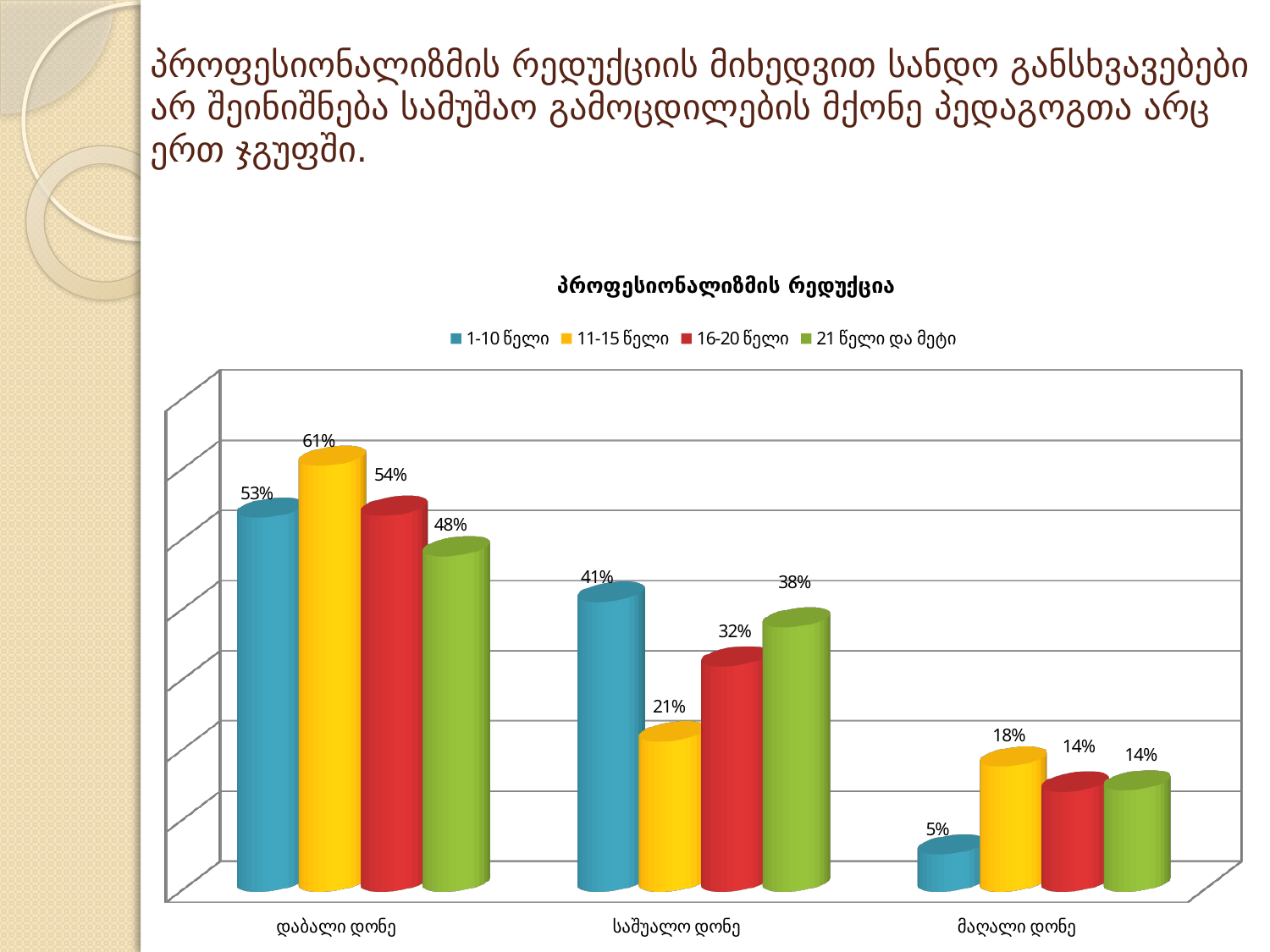
What is the value for 1-10 წელი in the საშუალო დონე category? 41% What kind of chart is shown on the slide? Bar chart What is the value for 11-15 წელი in the დაბალი დონე category? 61% What is the value for 21 წელი და მეტი in the მაღალი დონე category? 14% Which series has the highest value in the დაბალი დონე category? 11-15 წელი Which series has the lowest value in the მაღალი დონე category? 1-10 წელი What is the difference between the 1-10 წელი and 11-15 წელი values in the საშუალო დონე category? 20% How many series does the legend list? 4 Which is larger in the საშუალო დონე category: the value for 16-20 წელი or the value for 21 წელი და მეტი? 21 წელი და მეტი How many categories are shown on the x axis? 3 What is the title of the chart? პროფესიონალიზმის რედუქცია Do the values for 1-10 წელი rise or fall from დაბალი დონე to მაღალი დონე? Fall